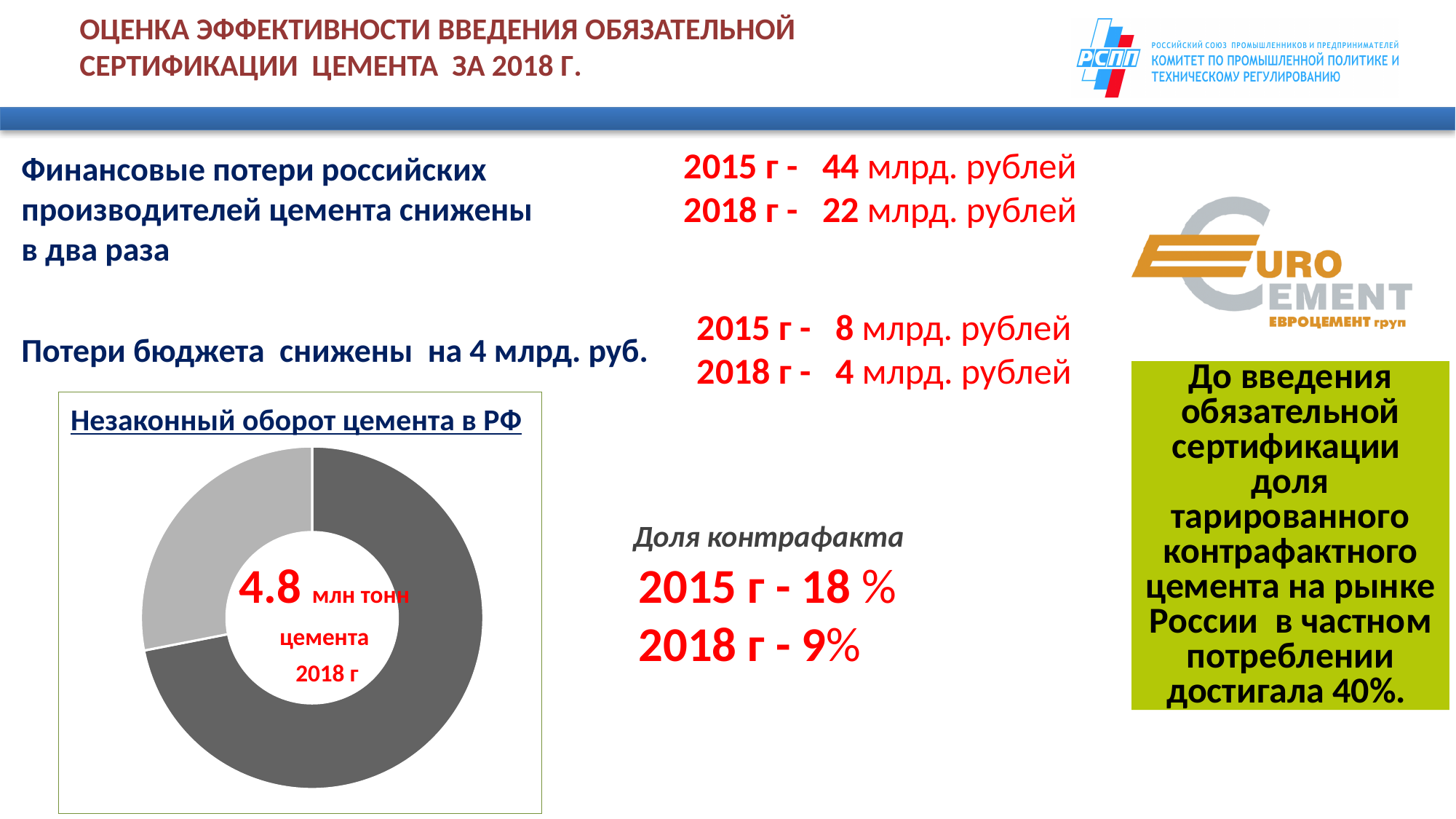
In the doughnut chart "Незаконный оборот цемента в РФ", is the light grey slice more or less than half of the ring? Less In the doughnut chart "Незаконный оборот цемента в РФ", which slice is larger, the dark grey one or the light grey one? The dark grey one What is the title of the doughnut chart on the slide? Незаконный оборот цемента в РФ Which year does the doughnut chart "Незаконный оборот цемента в РФ" refer to, according to its centre label? 2018 г What kind of chart is shown under the heading "Незаконный оборот цемента в РФ"? Doughnut (pie) chart What value is printed in the centre of the doughnut chart "Незаконный оборот цемента в РФ"? 4.8 млн тонн цемента 2018 г How many slices does the doughnut chart "Незаконный оборот цемента в РФ" have? 2